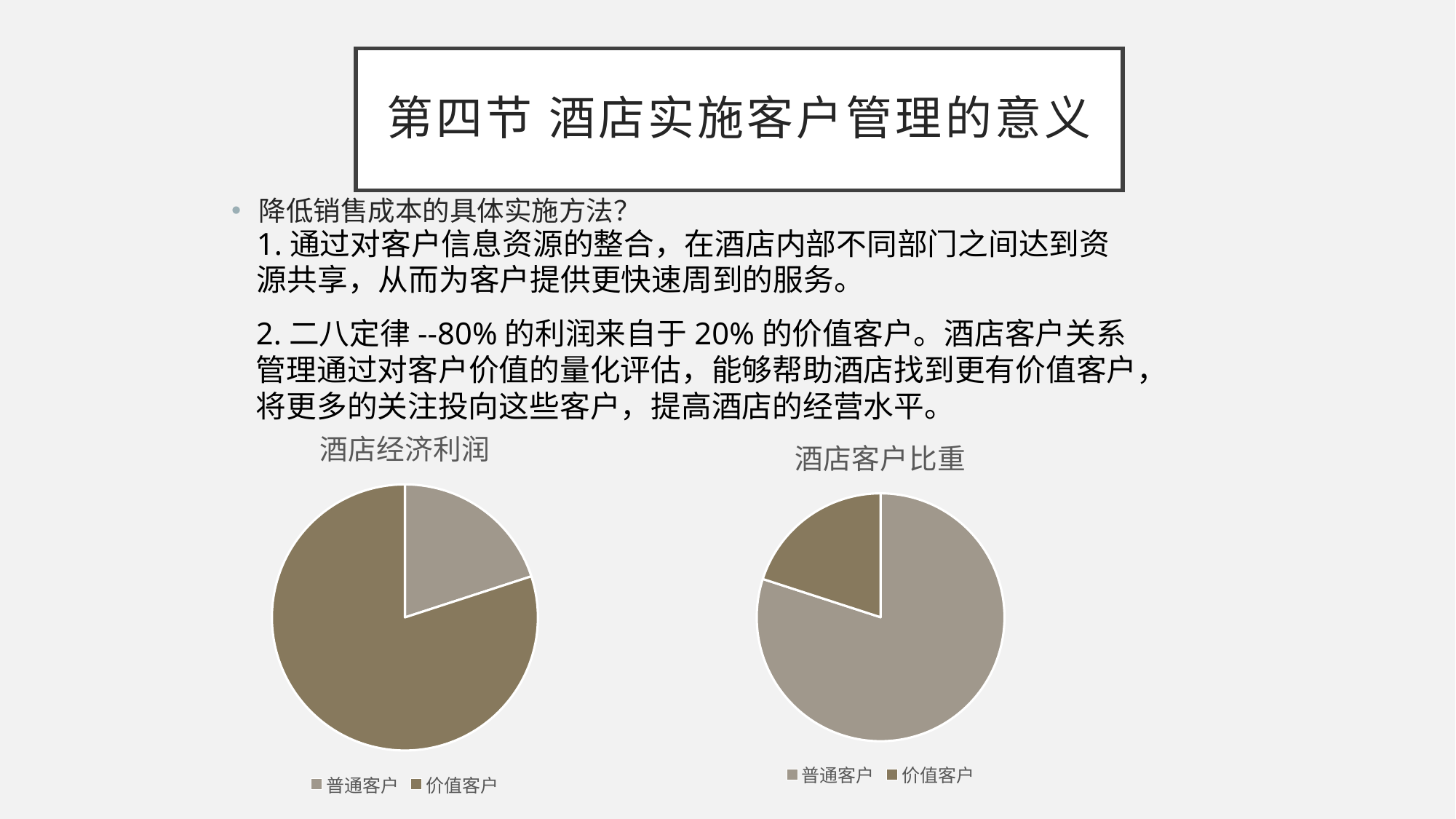
In the chart titled 酒店经济利润, which slice is larger: 普通客户 or 价值客户? 价值客户 What is the title of the pie chart on the left of the slide? 酒店经济利润 In the chart titled 酒店客户比重, which slice is larger: 普通客户 or 价值客户? 普通客户 How many slices does the chart titled 酒店经济利润 have? 2 In the chart titled 酒店客户比重, which category has the largest slice? 普通客户 In the chart titled 酒店经济利润, which category has the largest slice? 价值客户 In the chart titled 酒店经济利润, which category has the smallest slice? 普通客户 What is the title of the pie chart on the right of the slide? 酒店客户比重 What kind of chart is the chart titled 酒店客户比重? Pie chart How many entries does the legend of the chart titled 酒店客户比重 list? 2 What kind of chart is the chart titled 酒店经济利润? Pie chart In the chart titled 酒店客户比重, which category has the smallest slice? 价值客户